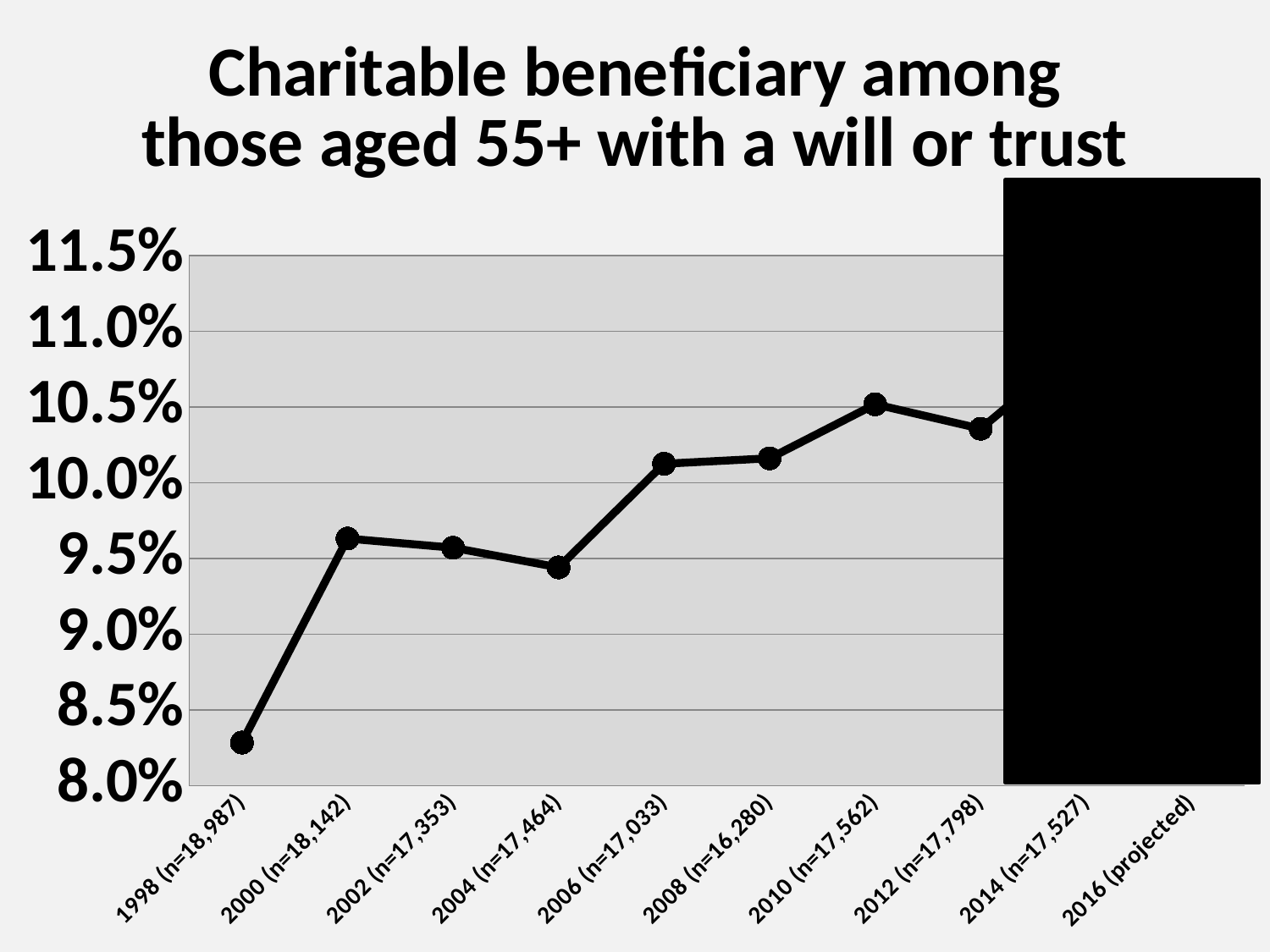
What is the title of the chart? Charitable beneficiary among those aged 55+ with a will or trust Is the value for 1998 (n=18,987) greater or less than 8.5%? less Which is larger, the value for 1998 (n=18,987) or the value for 2000 (n=18,142)? 2000 (n=18,142) How many categories are labelled on the x axis? 10 Is the value for 2010 (n=17,562) greater or less than 10.0%? greater Which visible year has the highest value? 2010 (n=17,562) What kind of chart is shown on the slide? line chart Overall, do the values rise or fall from 1998 to 2012? rise Which is larger, the value for 2004 (n=17,464) or the value for 2006 (n=17,033)? 2006 (n=17,033) Which visible year has the lowest value? 1998 (n=18,987) Is the value for 2000 (n=18,142) greater or less than 9.5%? greater